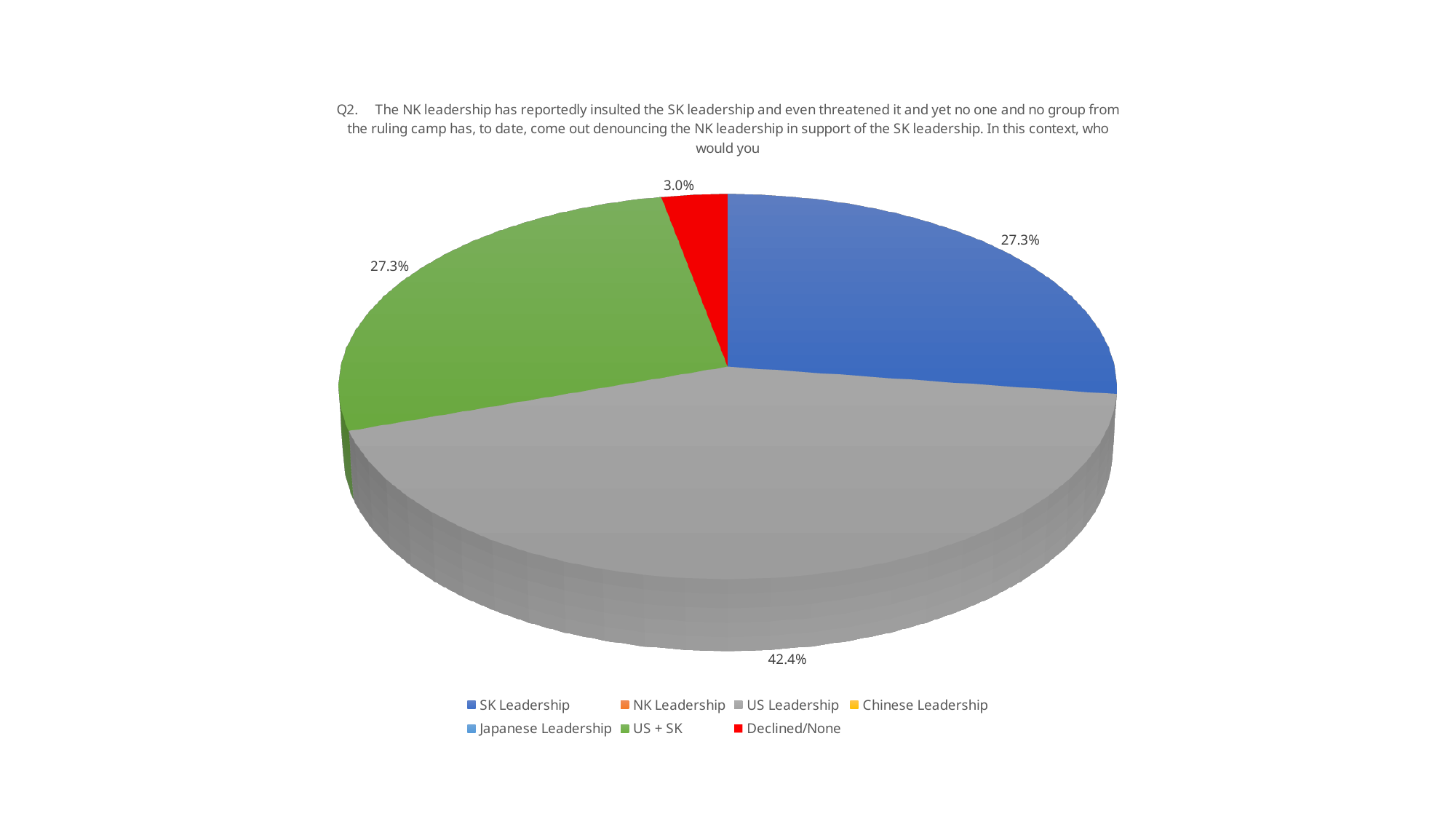
What percentage of the pie is Declined/None? 3.0% What percentage of the pie is SK Leadership? 27.3% Which category has the largest share of the pie? US Leadership What type of chart is shown on the slide? pie chart What is the difference in percentage points between US Leadership and SK Leadership? 15.1 What percentage of the pie is US Leadership? 42.4% Which is larger, the share for US Leadership or the share for US + SK? US Leadership How many slices are visible in the pie chart? 4 What colour is the US Leadership slice? gray How many entries does the legend list? 7 Which category has the smallest share of the pie? Declined/None What percentage of the pie is US + SK? 27.3%